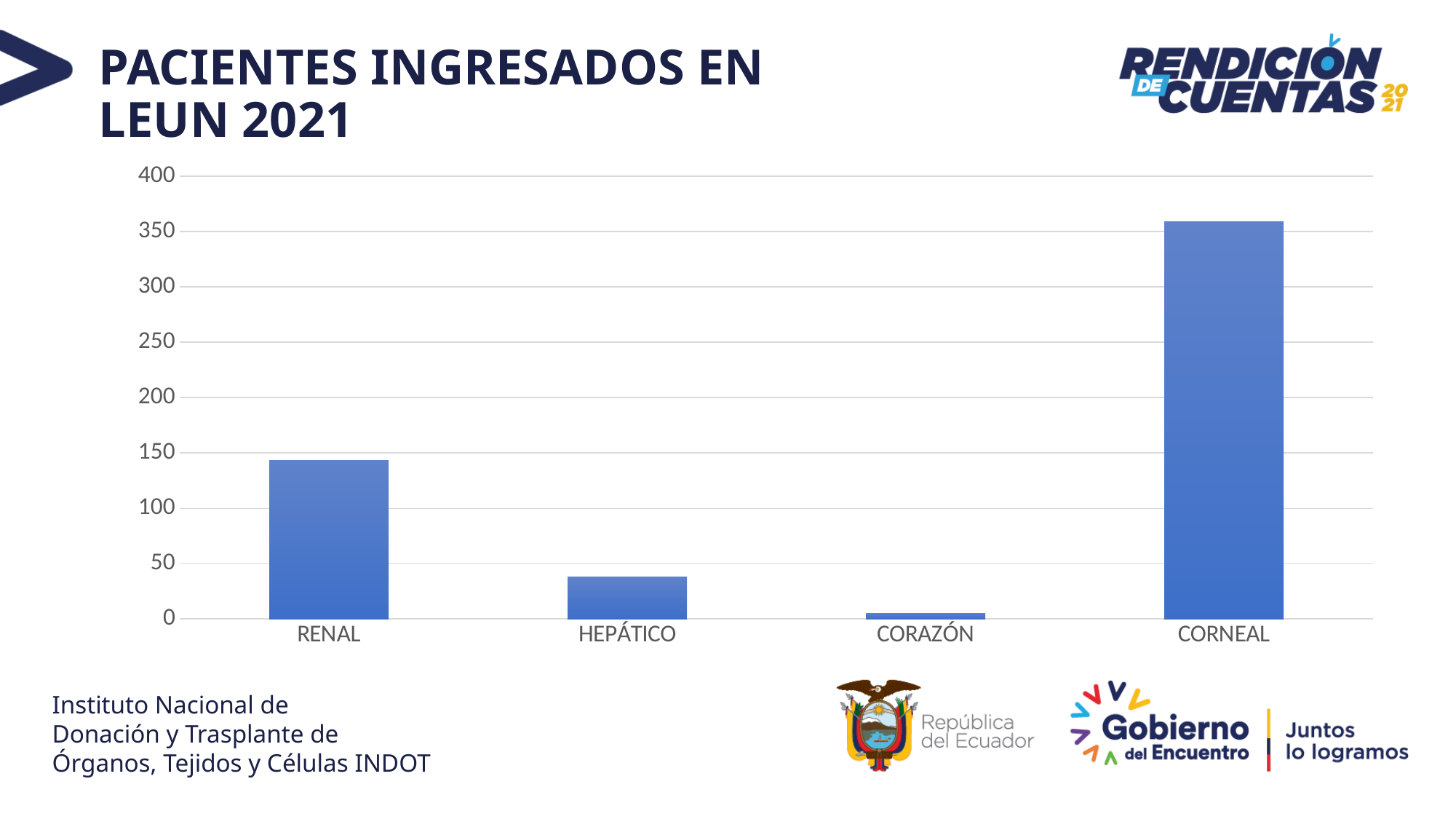
Which is larger, the value for RENAL or the value for HEPÁTICO? RENAL Is the value for CORAZÓN greater or less than 50? less Which category has the lowest value in the chart? CORAZÓN How many categories are shown on the x axis of the chart? 4 Which is larger, the value for CORNEAL or the value for RENAL? CORNEAL What is the title of the slide containing the chart? PACIENTES INGRESADOS EN LEUN 2021 Which category has the highest value in the chart? CORNEAL Is the value for RENAL greater or less than 100? greater Is the value for CORNEAL greater or less than 300? greater What kind of chart is shown on the slide? bar chart What is the highest value shown on the y axis of the chart? 400